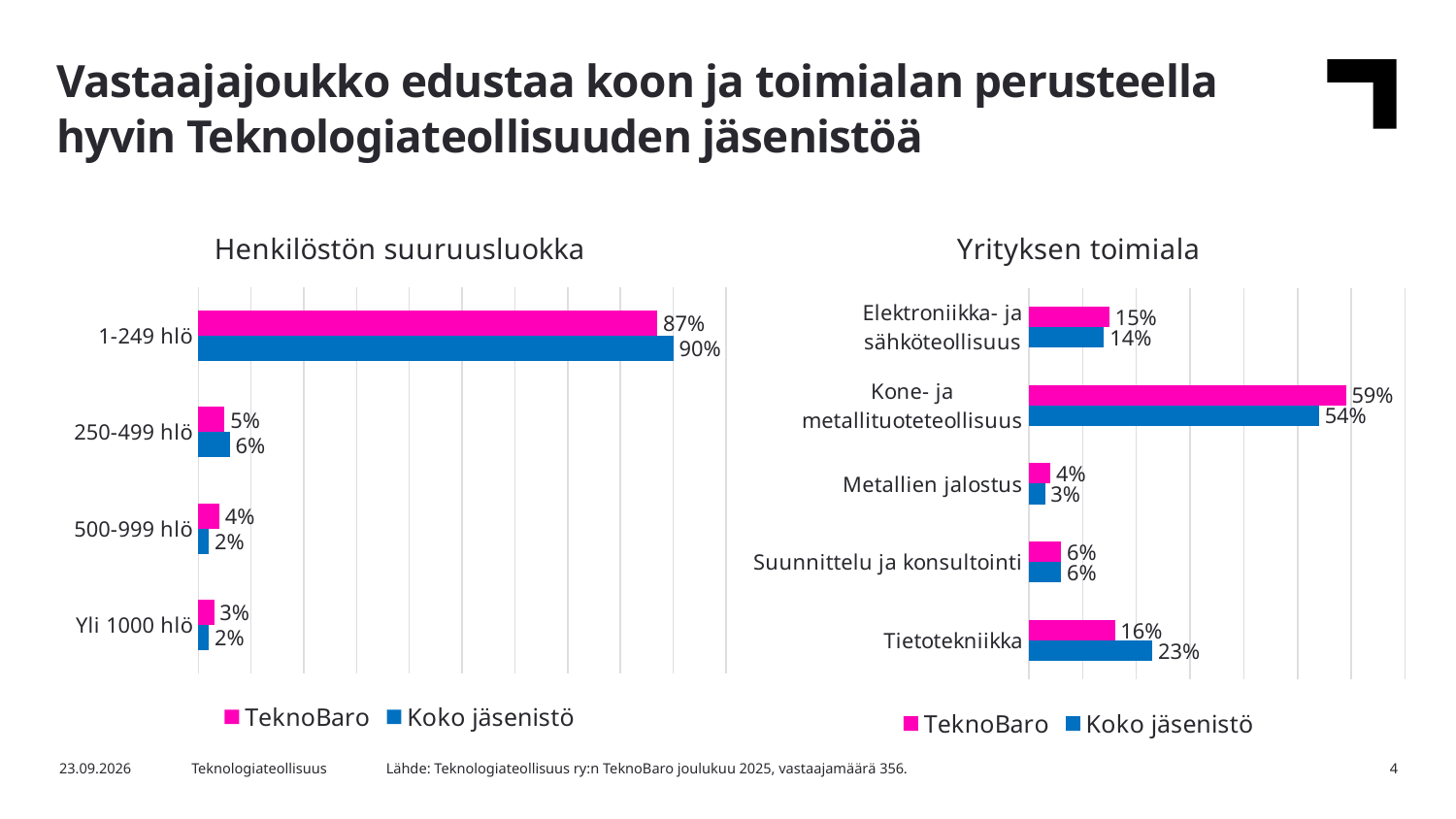
What type of chart is the 'Henkilöstön suuruusluokka' chart? Bar chart In the 'Yrityksen toimiala' chart, what is the TeknoBaro value for Kone- ja metallituoteteollisuus? 59% In the 'Yrityksen toimiala' chart, which category has the lowest Koko jäsenistö value? Metallien jalostus In the 'Yrityksen toimiala' chart, what is the Koko jäsenistö value for Tietotekniikka? 23% In the 'Yrityksen toimiala' chart, which is larger for Tietotekniikka: the TeknoBaro value or the Koko jäsenistö value? Koko jäsenistö In the 'Henkilöstön suuruusluokka' chart, what is the Koko jäsenistö value for 250-499 hlö? 6% In the 'Yrityksen toimiala' chart, what is the difference between the TeknoBaro and Koko jäsenistö values for Kone- ja metallituoteteollisuus? 5% In the 'Henkilöstön suuruusluokka' chart, what is the TeknoBaro value for 1-249 hlö? 87% In the 'Henkilöstön suuruusluokka' chart, which category has the highest TeknoBaro value? 1-249 hlö In the 'Henkilöstön suuruusluokka' chart, how many categories are shown? 4 In the 'Henkilöstön suuruusluokka' chart, what is the difference between the Koko jäsenistö and TeknoBaro values for 1-249 hlö? 3% How many series does the legend of the 'Yrityksen toimiala' chart list? 2